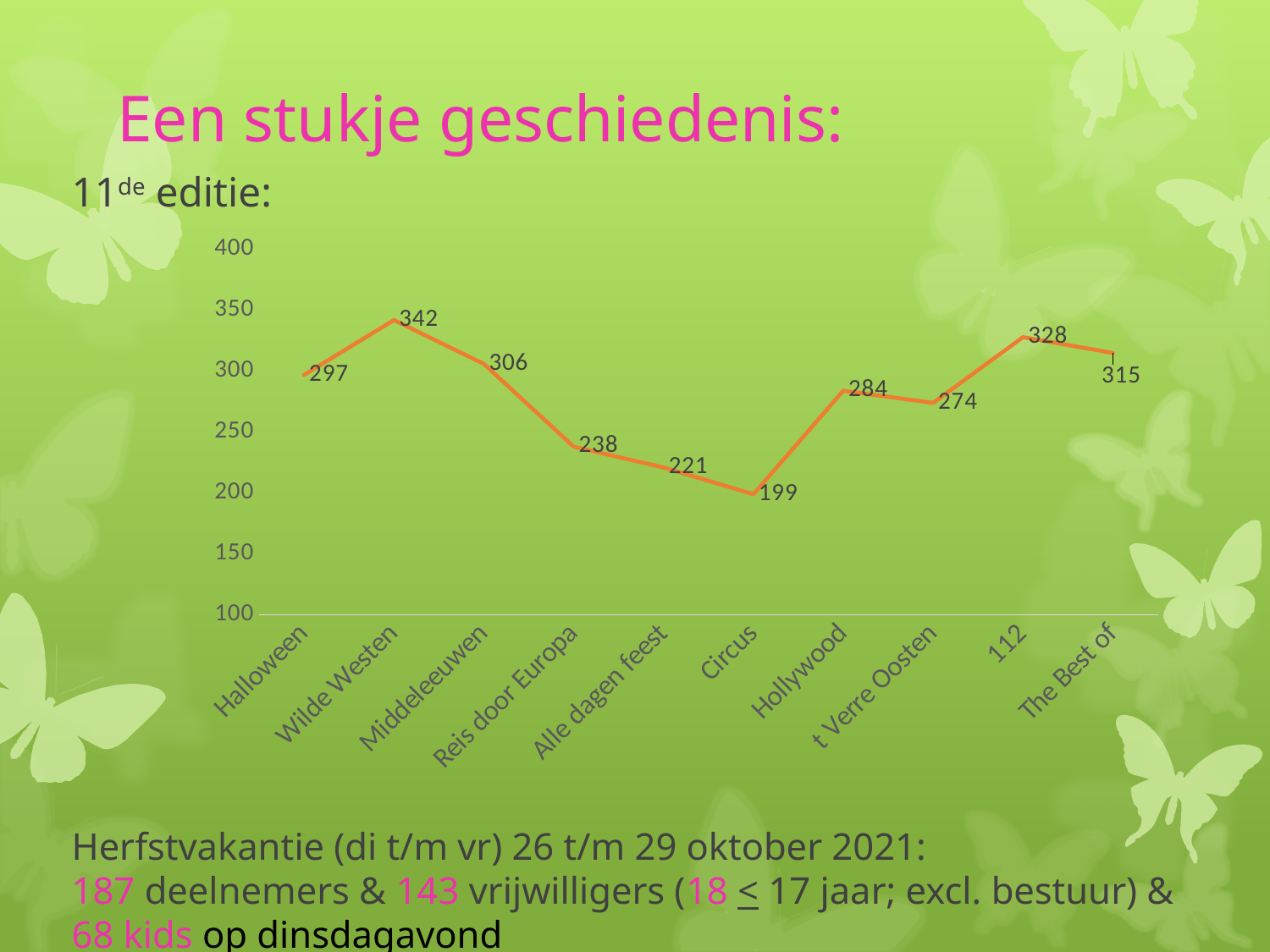
How many categories are shown on the x axis? 10 What is the difference between the values for Wilde Westen and Circus? 143 What is the value for Wilde Westen? 342 Do the values rise or fall from Middeleeuwen to Circus? fall What is the value for Circus? 199 Which category has the lowest value? Circus Which is larger, the value for Halloween or the value for Middeleeuwen? Middeleeuwen Which category has the highest value? Wilde Westen What is the value for The Best of? 315 Is the value for Hollywood greater or less than 250? greater What is the difference between the values for 112 and 't Verre Oosten? 54 What kind of chart is shown on the slide? line chart